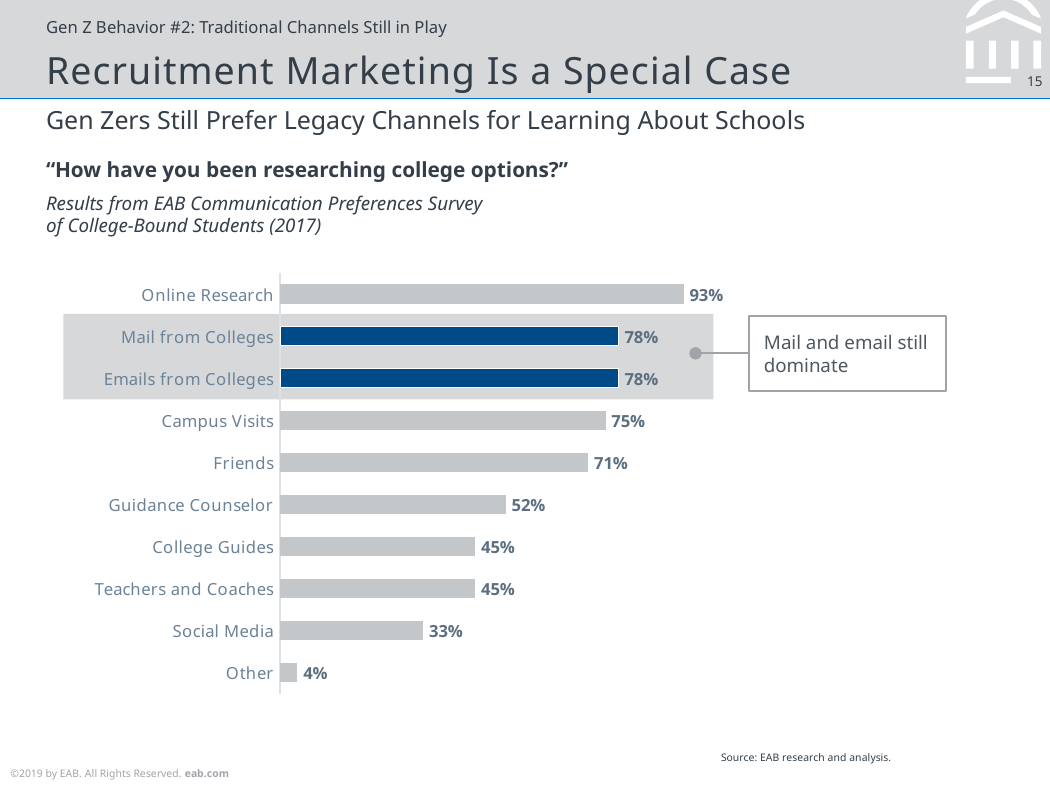
What is the difference between the values for Online Research and Campus Visits? 18% What is the value shown for Guidance Counselor? 52% What is the difference between the values for Friends and Social Media? 38% What percentage of respondents reported using Online Research to research college options? 93% Which two categories are highlighted in dark blue in the chart? Mail from Colleges and Emails from Colleges What does the callout box next to the highlighted bars say? Mail and email still dominate Which category has the lowest value in the chart? Other What kind of chart is shown on the slide? Bar chart What is the value shown for Social Media? 33% Which category has the highest value in the chart? Online Research How many categories are shown in the chart? 10 Which is larger, the value for Campus Visits or the value for Friends? Campus Visits